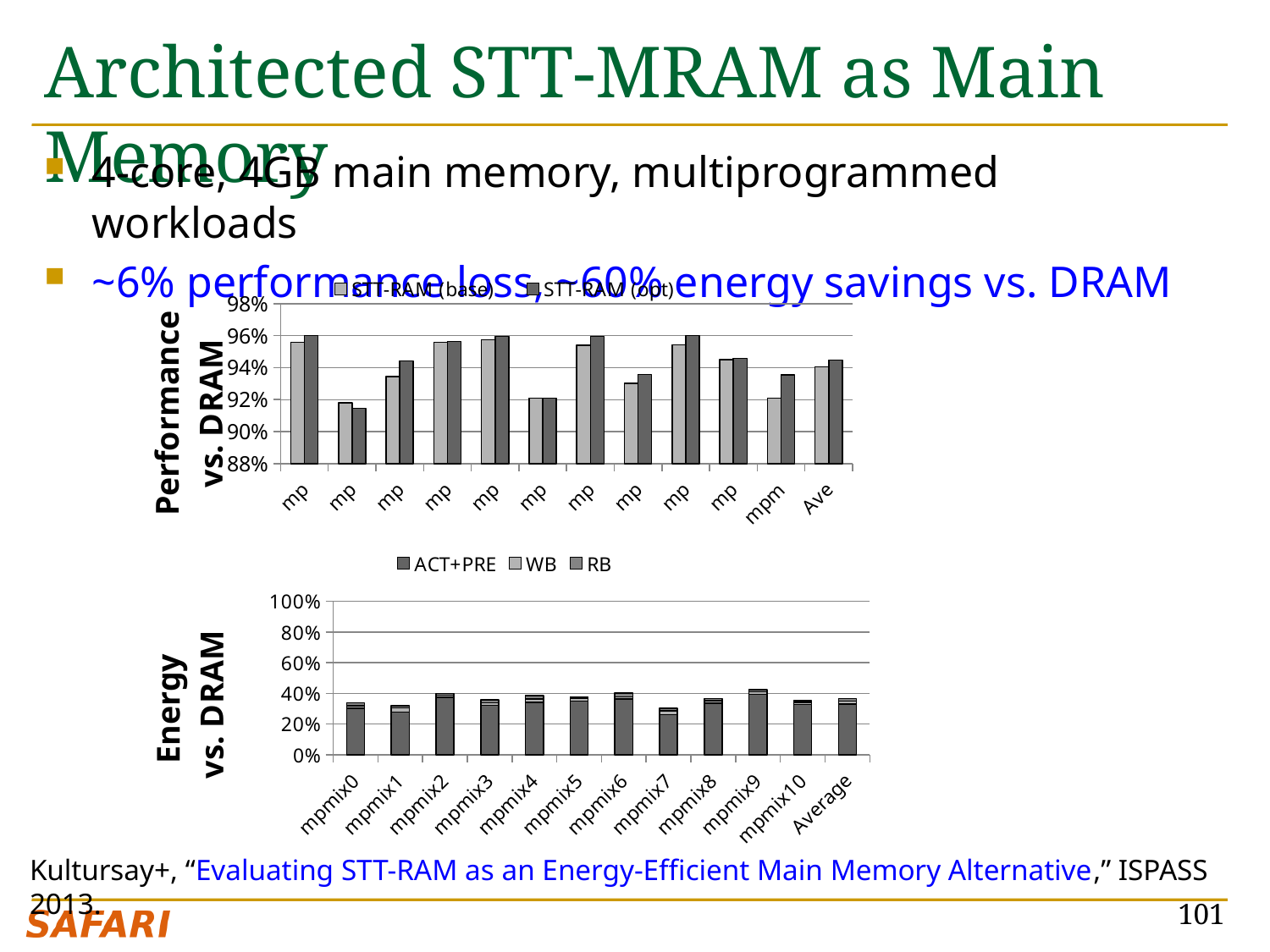
In the bottom chart (Energy vs. DRAM), which category has the highest total bar? mpmix9 In the top chart (Performance vs. DRAM), are the values for the Ave category greater or less than 92%? greater In the bottom chart (Energy vs. DRAM), is the total for mpmix7 greater or less than 40%? less In the bottom chart (Energy vs. DRAM), how many series does the legend list? 3 What kind of chart is the bottom chart (Energy vs. DRAM)? bar chart What kind of chart is the top chart (Performance vs. DRAM)? bar chart In the bottom chart (Energy vs. DRAM), which has the larger total bar, mpmix9 or mpmix7? mpmix9 In the bottom chart (Energy vs. DRAM), is the total for mpmix0 greater or less than 20%? greater In the bottom chart (Energy vs. DRAM), how many categories are shown on the x axis? 12 In the bottom chart (Energy vs. DRAM), which has the larger total bar, mpmix2 or mpmix1? mpmix2 In the bottom chart (Energy vs. DRAM), what are the three legend entries? ACT+PRE, WB, RB